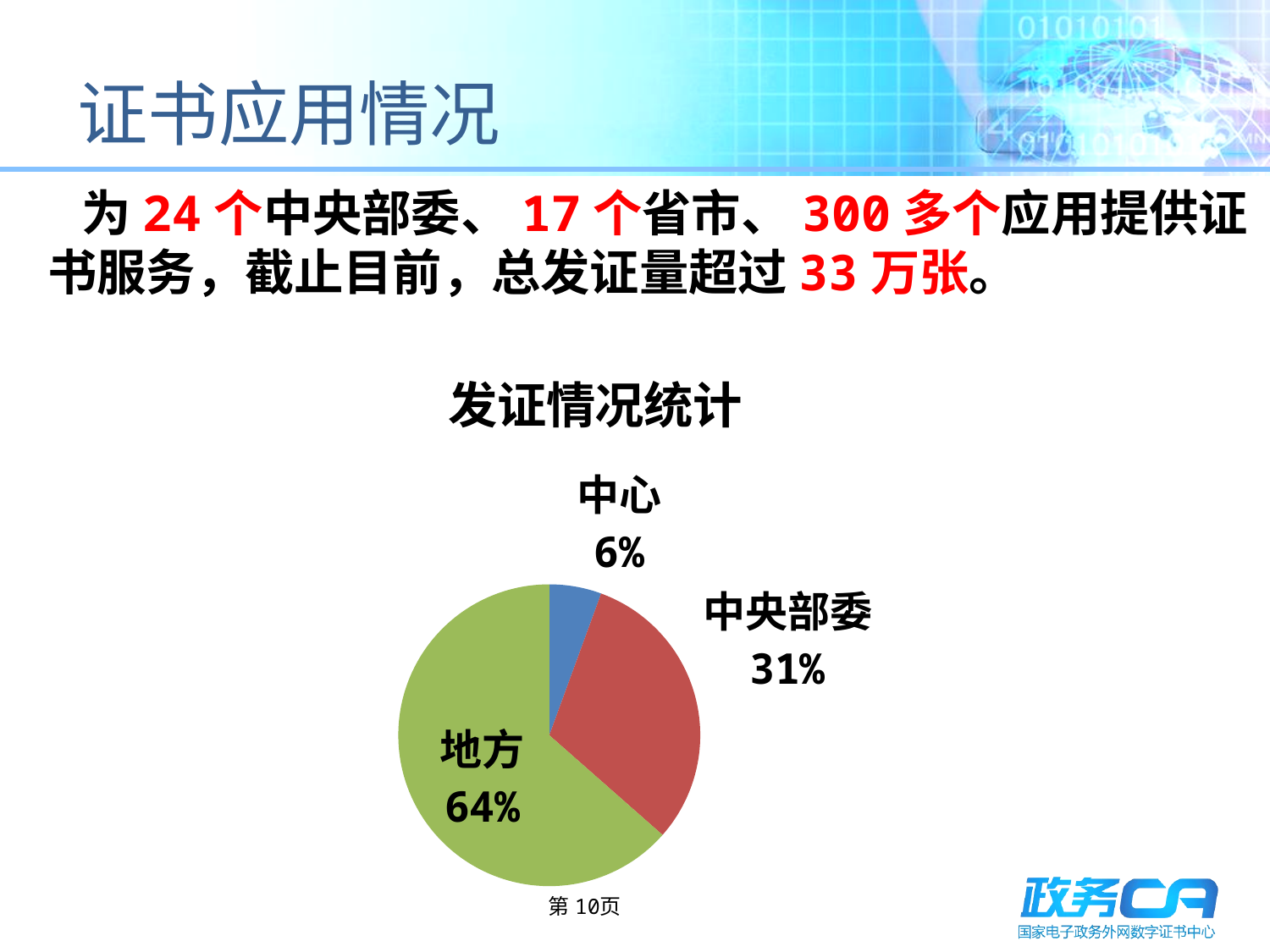
What is the difference in percentage points between the 地方 share and the 中央部委 share? 33 How many slices does the pie chart have? 3 What share of the pie does 地方 hold? 64% What colour is the 地方 slice of the pie? green What is the difference in percentage points between the 中央部委 share and the 中心 share? 25 What share of the pie does 中央部委 hold? 31% What share of the pie does 中心 hold? 6% Which category has the smallest slice of the pie? 中心 Which is larger, the share for 中央部委 or the share for 中心? 中央部委 What is the title of the chart? 发证情况统计 Which category has the largest slice of the pie? 地方 What type of chart is shown under the title 发证情况统计? pie chart